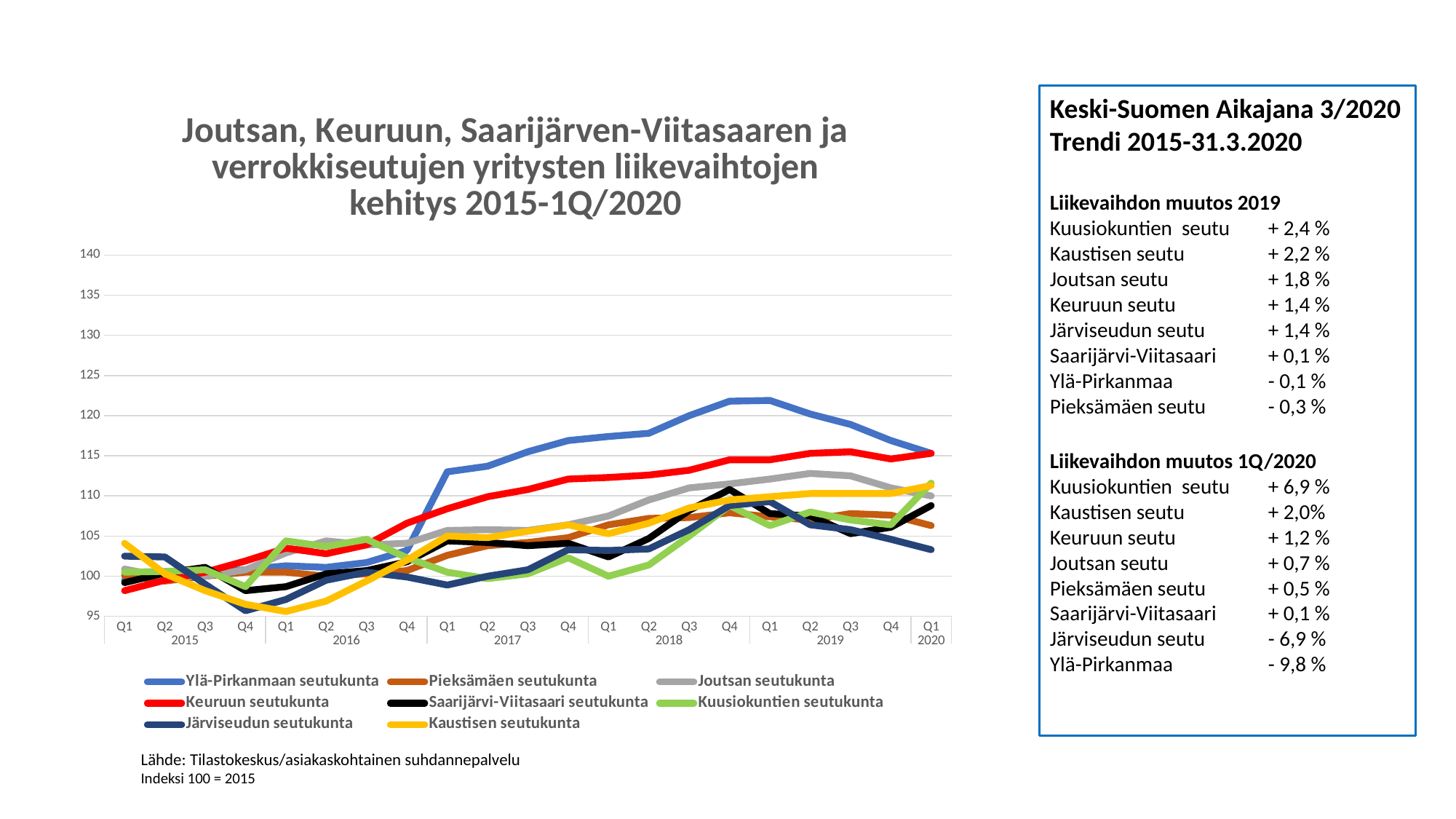
Is the value for Ylä-Pirkanmaan seutukunta at Q1 2019 greater or less than 115? greater Which series has the highest value at Q1 2019? Ylä-Pirkanmaan seutukunta Which series has the lowest value at Q1 2020? Järviseudun seutukunta At Q1 2020, which is larger: the value for Ylä-Pirkanmaan seutukunta or the value for Järviseudun seutukunta? Ylä-Pirkanmaan seutukunta Does the value for Ylä-Pirkanmaan seutukunta rise or fall from Q1 2019 to Q1 2020? fall How many series does the chart legend list? 8 Is the value for Kaustisen seutukunta at Q1 2016 greater or less than 100? less Does the value for Keuruun seutukunta rise or fall overall from Q1 2015 to Q1 2020? rise Is the value for Järviseudun seutukunta at Q1 2020 greater or less than 105? less What colour is the line for Keuruun seutukunta in the chart? red What kind of chart is shown on the slide? line chart How many quarterly points are plotted along the x axis of the chart? 21